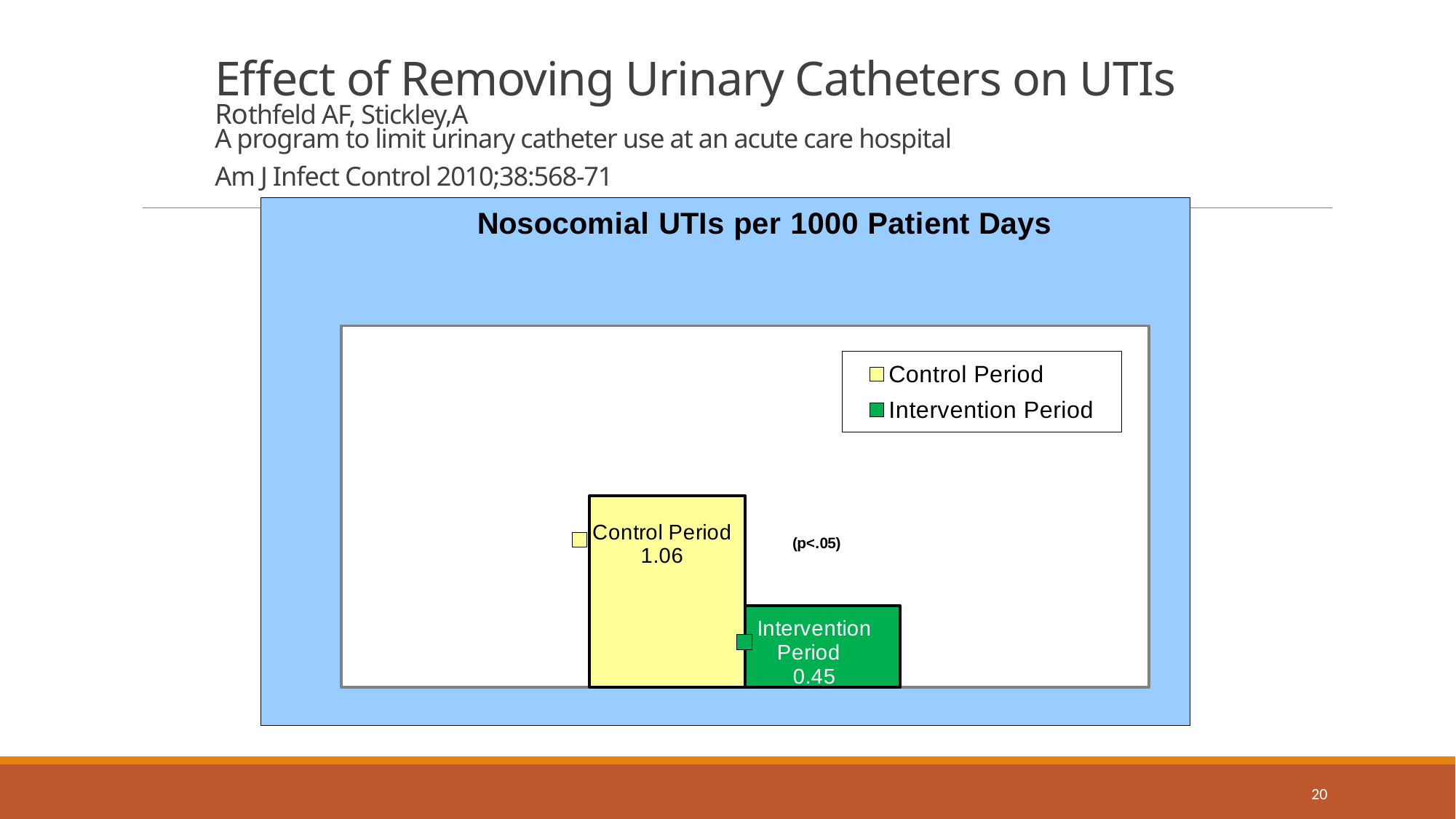
How many series does the legend list? 2 What p-value annotation is shown on the chart? (p<.05) What is the title of the chart? Nosocomial UTIs per 1000 Patient Days What kind of chart is shown on the slide? bar chart How many bars are plotted in the chart? 2 What colour is the Intervention Period bar? green Is the value for the Control Period larger or smaller than the value for the Intervention Period? larger What is the value for the Control Period? 1.06 What is the value for the Intervention Period? 0.45 Which period has the lower rate of nosocomial UTIs per 1000 patient days? Intervention Period What is the difference between the Control Period and Intervention Period values? 0.61 Which period has the higher rate of nosocomial UTIs per 1000 patient days? Control Period